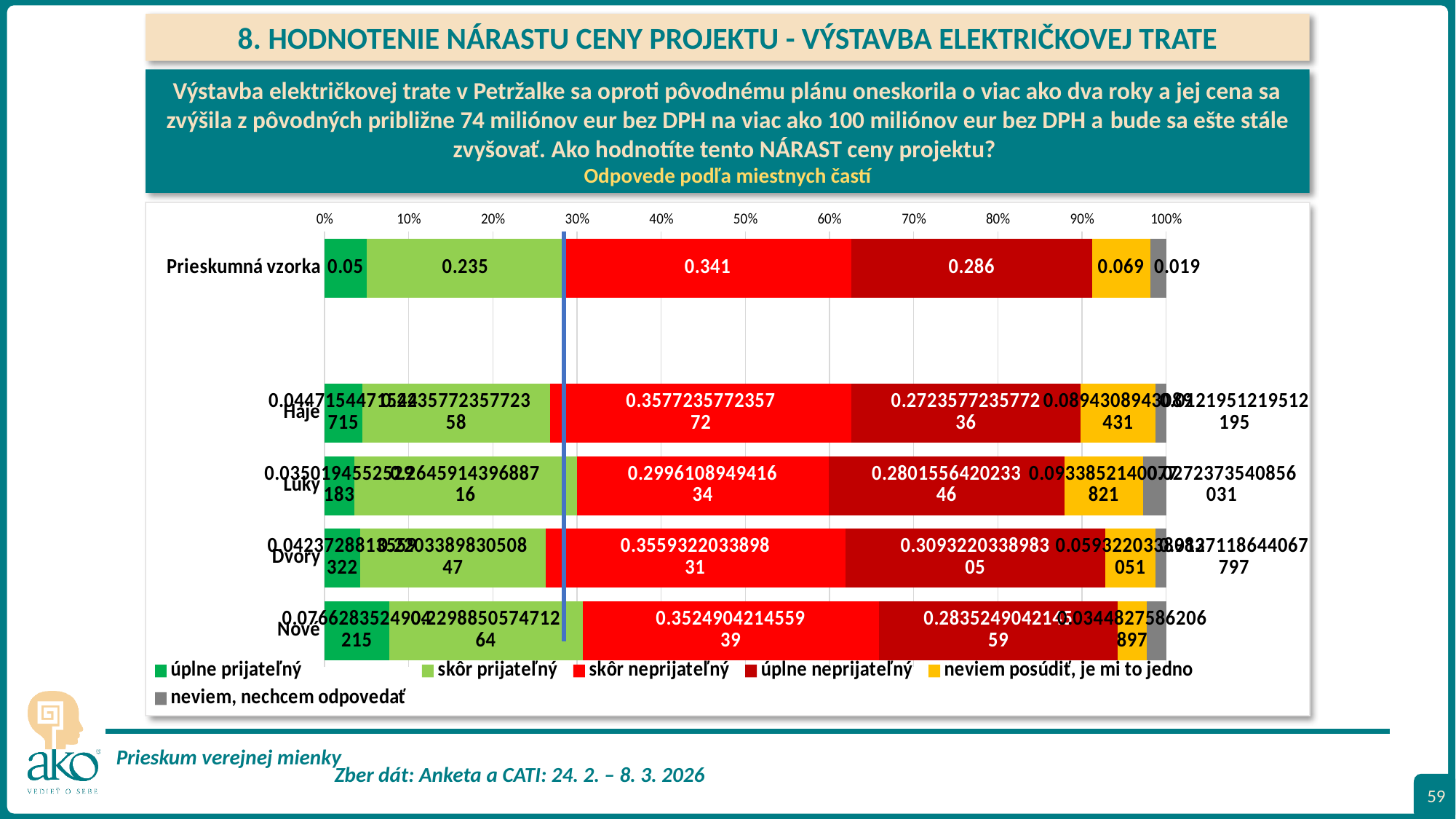
What is the value for 'úplne neprijateľný' in the 'Prieskumná vzorka' bar? 0.286 Which response category has the largest share in the 'Prieskumná vzorka' bar? skôr neprijateľný What colour represents 'úplne neprijateľný' in the chart? dark red What is the value for 'úplne prijateľný' in the 'Prieskumná vzorka' bar? 0.05 In the 'Prieskumná vzorka' bar, which is larger: 'skôr prijateľný' or 'úplne neprijateľný'? úplne neprijateľný In the 'Prieskumná vzorka' bar, what is the difference between the 'skôr neprijateľný' and 'úplne neprijateľný' values? 0.055 What is the value for 'neviem posúdiť, je mi to jedno' in the 'Prieskumná vzorka' bar? 0.069 What kind of chart is shown on the slide? stacked bar chart What is the value for 'skôr neprijateľný' in the 'Prieskumná vzorka' bar? 0.341 How many bars (categories) are plotted in the chart? 5 Which response category has the smallest share in the 'Prieskumná vzorka' bar? neviem, nechcem odpovedať How many series does the legend list? 6